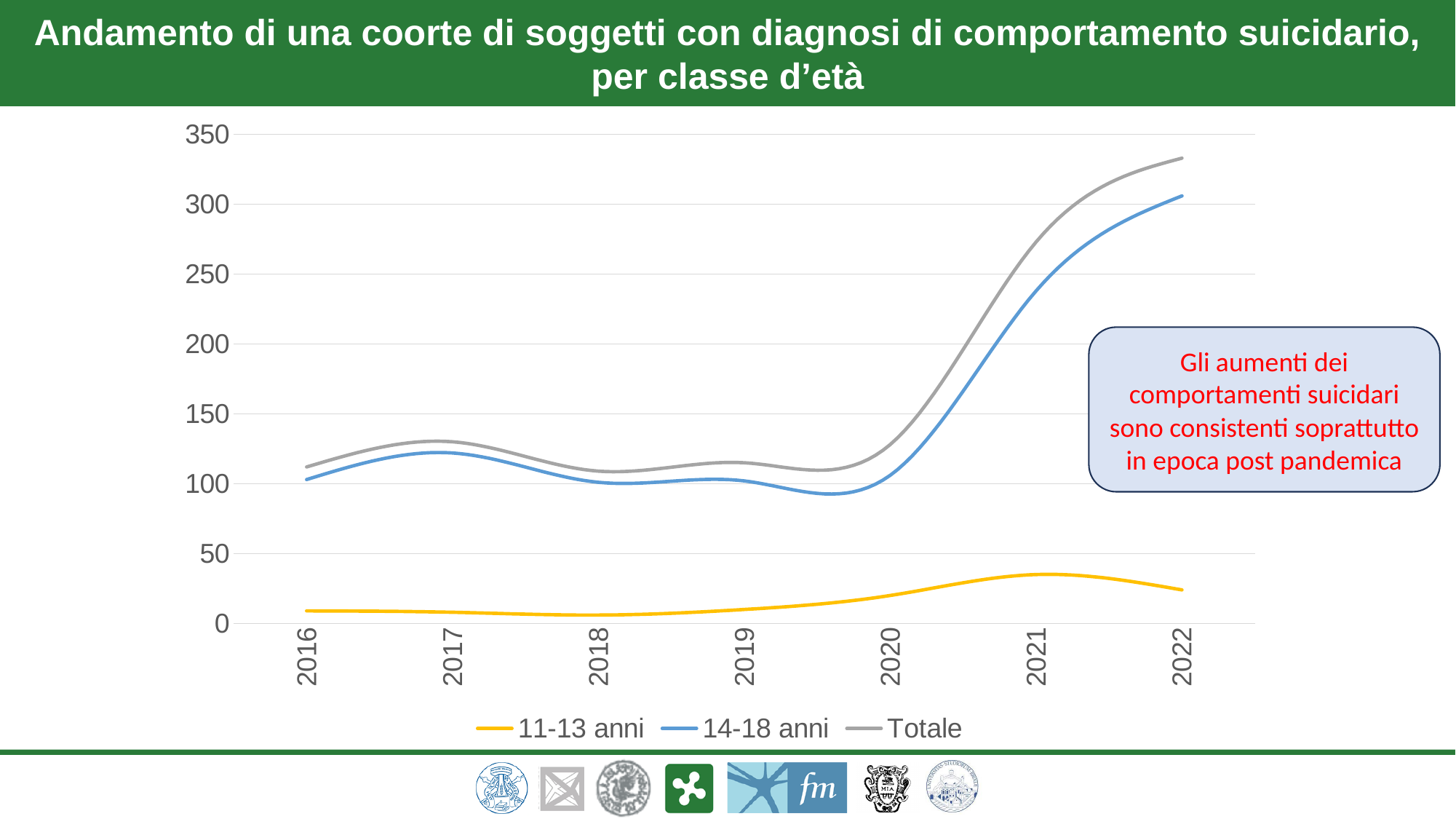
Is the value for Totale in 2022 greater or less than 300? greater Which series has the highest value in 2022? Totale Is the value for 11-13 anni in 2021 greater or less than 50? less In which year does the Totale series reach its highest value? 2022 How many series does the legend list? 3 What kind of chart is shown on the slide? line chart Is the value for 14-18 anni in 2022 greater or less than 250? greater Which series is drawn in yellow? 11-13 anni How many years are shown on the x axis? 7 Does the Totale series rise or fall between 2020 and 2022? rise Which series has the lowest values across all years? 11-13 anni